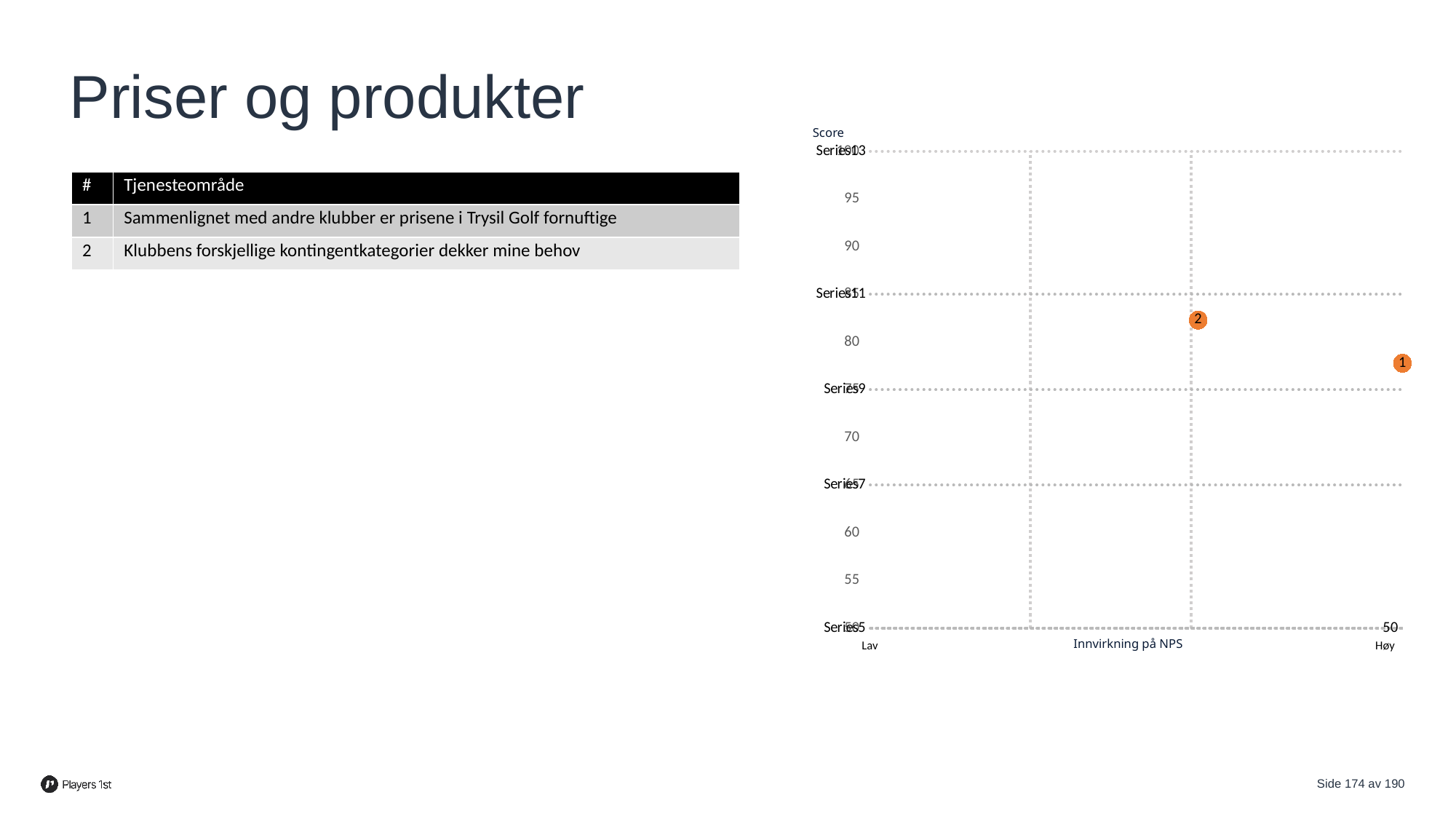
What is the label of the vertical axis of the chart? Score Is the score for point 1 greater or less than 80? less What kind of chart is shown on the right of the slide? scatter chart Which point has the higher score, point 1 or point 2? point 2 Which point has the higher impact on NPS (further toward Høy), point 1 or point 2? point 1 Is the score for point 2 greater or less than 85? less What is the label of the horizontal axis of the chart? Innvirkning på NPS Which point has the lowest score on the chart? point 1 Is the score for point 2 greater or less than 80? greater Which point has the highest score on the chart? point 2 How many data points are plotted on the chart? 2